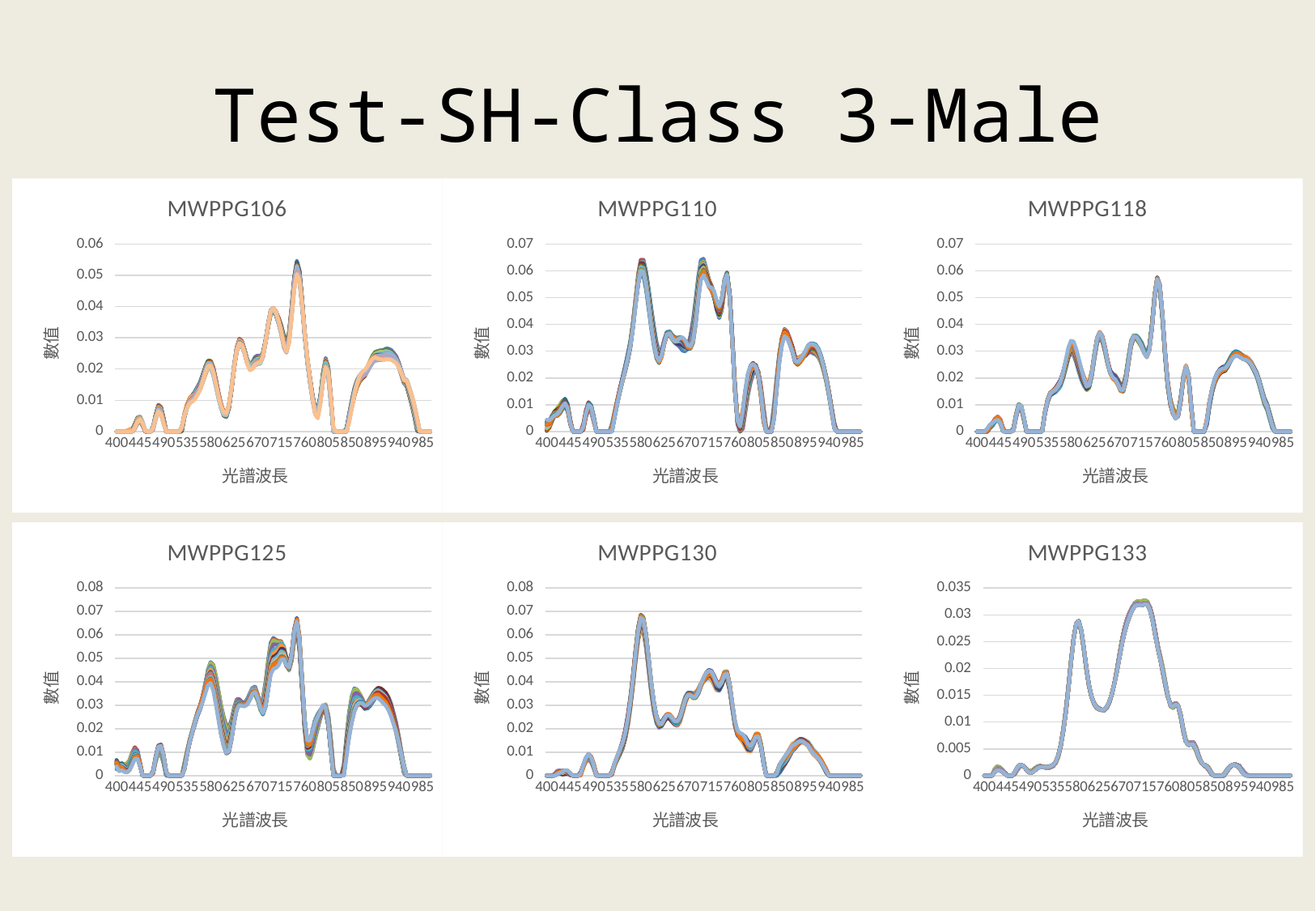
In the MWPPG125 chart, is the peak value near 760 greater or less than 0.06? greater In the MWPPG110 chart, is the peak value near 580 greater or less than 0.05? greater In the MWPPG106 chart, is the peak value near 760 greater or less than 0.05? greater What kind of chart is MWPPG106? line chart In the MWPPG130 chart, do the values rise or fall along the x axis from 535 to 580? rise In the MWPPG133 chart, do the values rise or fall along the x axis from 715 to 850? fall How many charts are shown on the slide? 6 What is the highest tick shown on the y axis of the MWPPG133 chart? 0.035